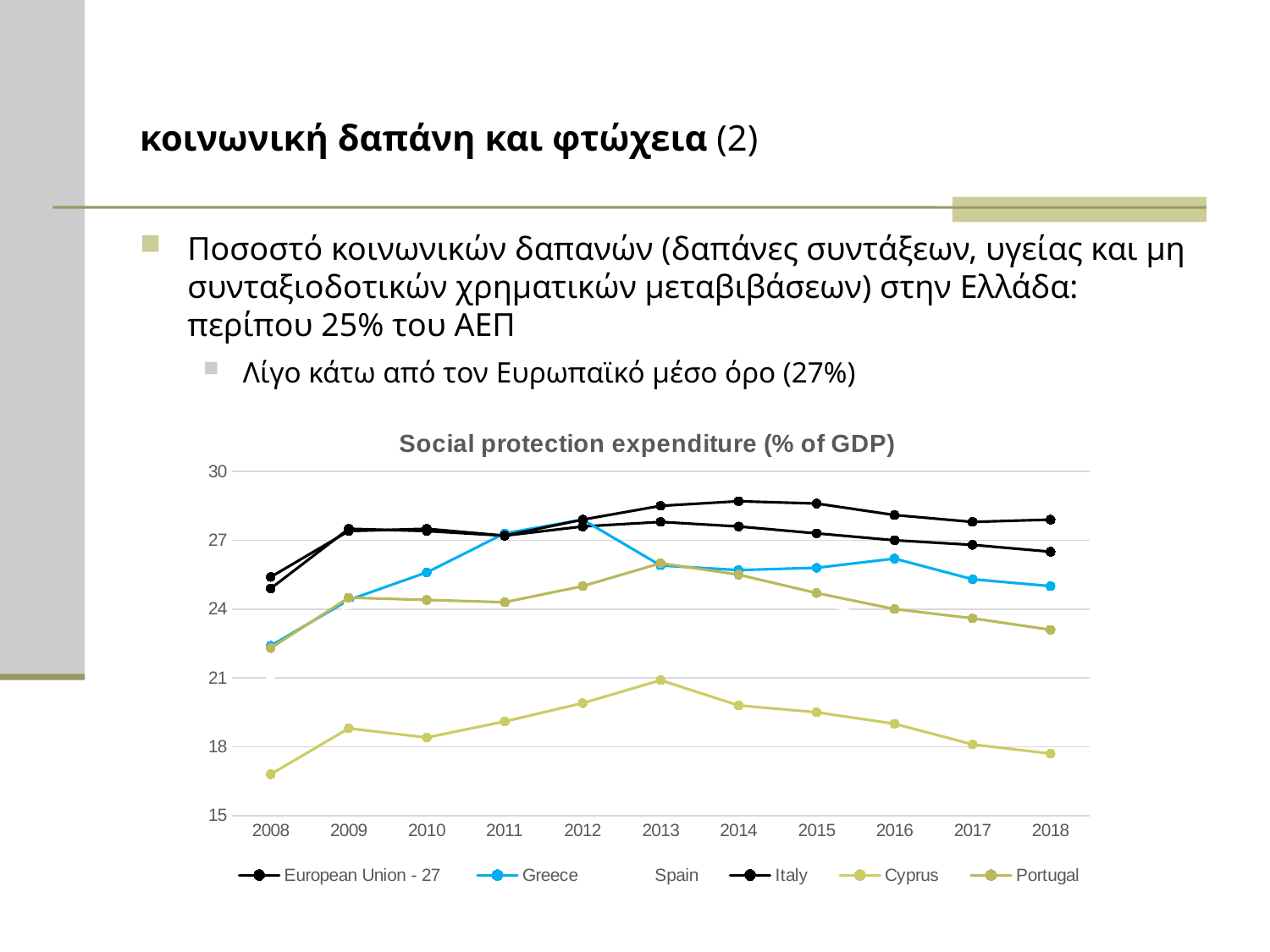
Does the value for Portugal rise or fall from 2013 to 2018? fall Is the value for Italy in 2014 greater or less than 27? greater Which country has the lowest social protection expenditure across all years shown? Cyprus What is the title of the chart? Social protection expenditure (% of GDP) Is the value for Cyprus in 2008 greater or less than 18? less Is the value for Greece in 2008 greater or less than 24? less How many series does the chart legend list? 6 What kind of chart is shown on the slide? line chart Does the value for Cyprus rise or fall from 2008 to 2013? rise How many years are plotted along the x axis? 11 Which is higher in 2016, Greece or Portugal? Greece